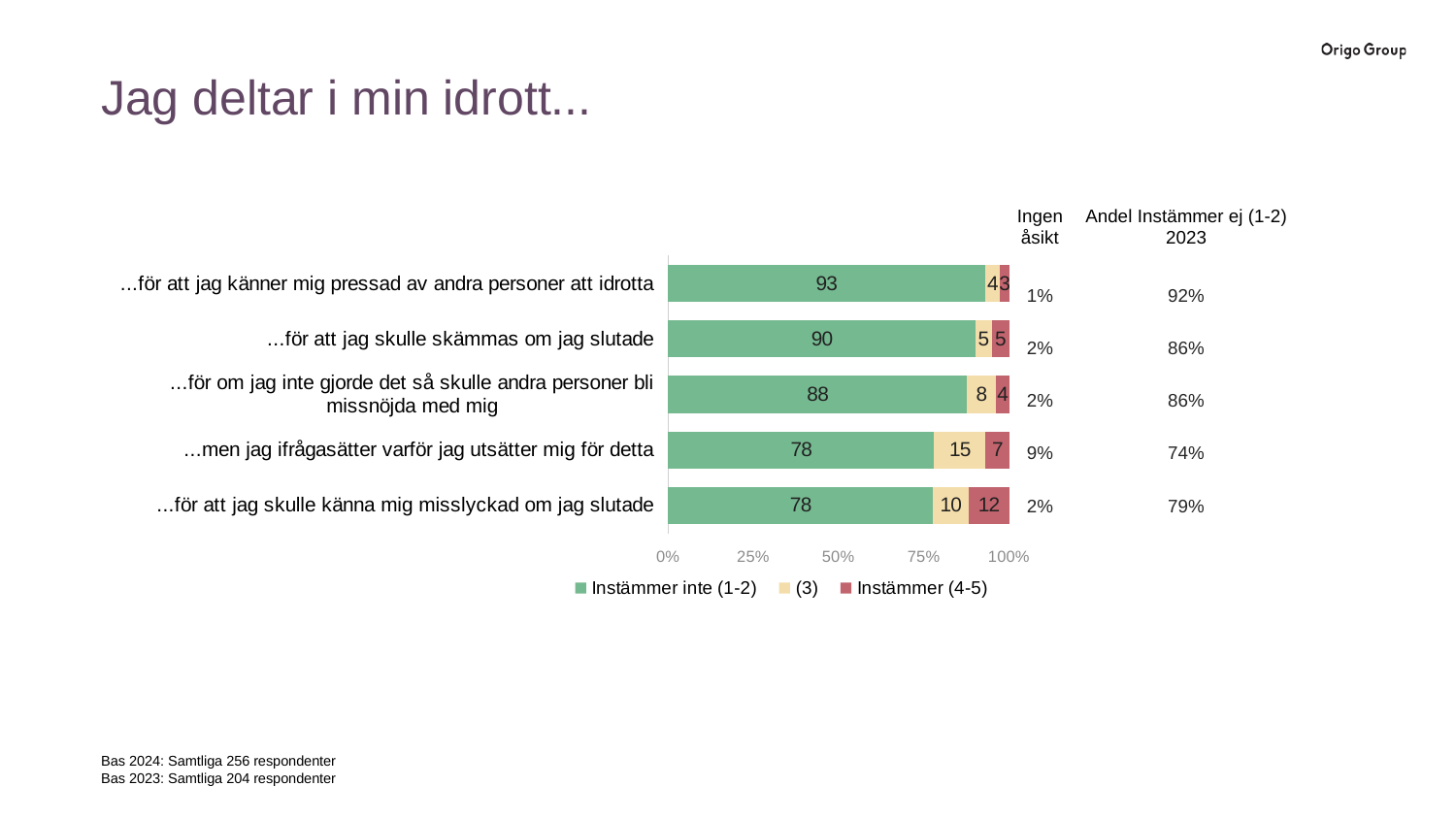
How many categories (statements) are plotted in the chart? 5 What is the total of the stacked bar for '...för att jag skulle skämmas om jag slutade'? 100 What is the difference between the 'Instämmer inte (1-2)' values for '...för att jag skulle skämmas om jag slutade' and '...men jag ifrågasätter varför jag utsätter mig för detta'? 12 What type of chart is shown on the slide? Stacked bar chart Which statement has the highest value for 'Instämmer inte (1-2)'? ...för att jag känner mig pressad av andra personer att idrotta How many series does the legend list? 3 What is the title of the slide? Jag deltar i min idrott... What is the value of '(3)' for '...men jag ifrågasätter varför jag utsätter mig för detta'? 15 What is the value of 'Instämmer (4-5)' for '...för att jag skulle känna mig misslyckad om jag slutade'? 12 What is the value of 'Instämmer inte (1-2)' for '...för att jag känner mig pressad av andra personer att idrotta'? 93 Which statement has the highest value for 'Instämmer (4-5)'? ...för att jag skulle känna mig misslyckad om jag slutade Which is larger: the '(3)' value for '...för om jag inte gjorde det så skulle andra personer bli missnöjda med mig' or for '...för att jag skulle känna mig misslyckad om jag slutade'? ...för att jag skulle känna mig misslyckad om jag slutade